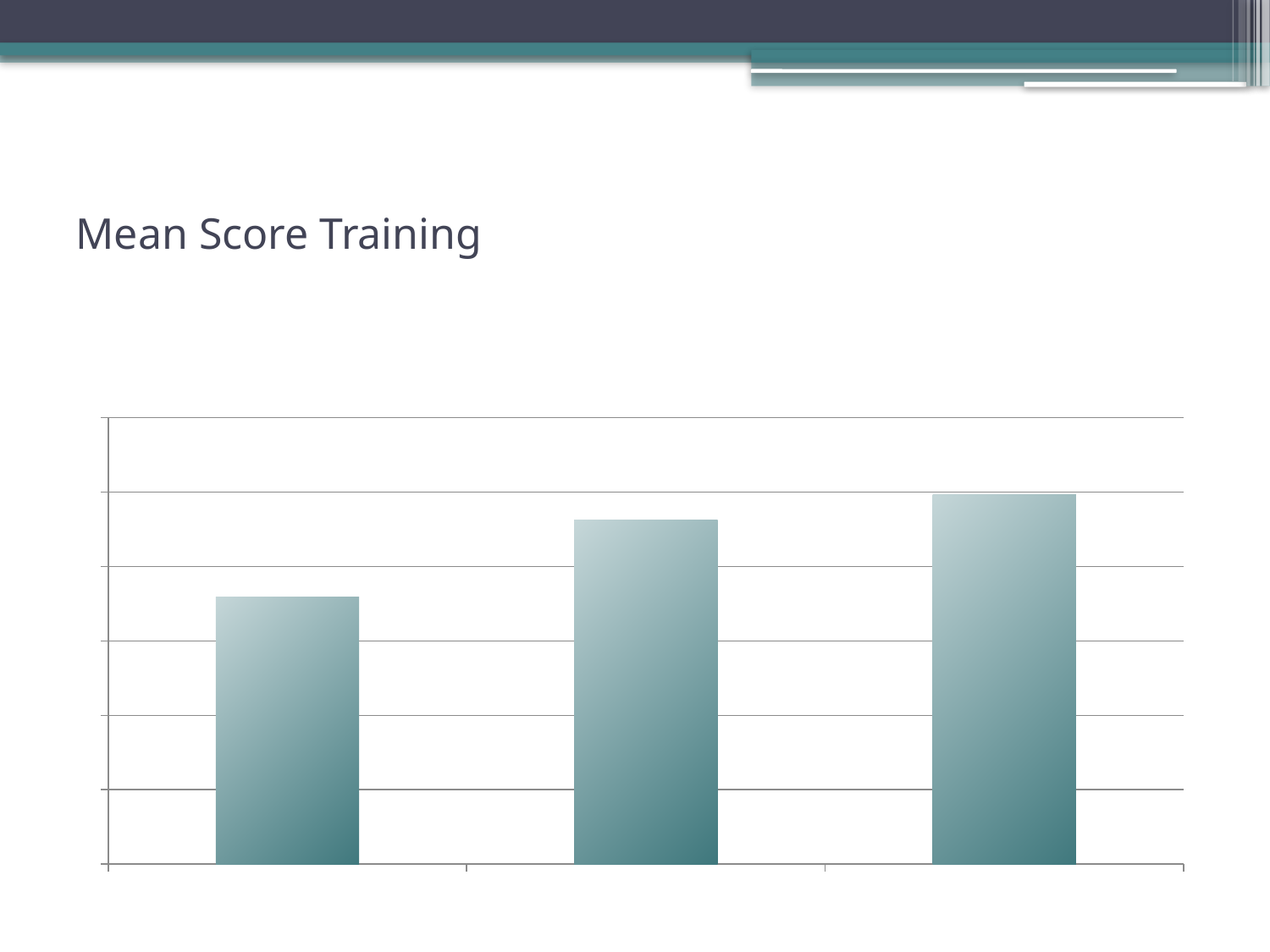
How many bars are plotted in the chart? 3 Which bar is the tallest: the left, middle, or right bar? right What kind of chart is shown on the slide? bar chart Which bar is the shortest: the left, middle, or right bar? left Is the middle bar taller or shorter than the left bar? taller Does the chart display a legend? No Is the right bar taller or shorter than the middle bar? taller Do the bar heights rise or fall from left to right across the chart? rise What is the title shown on the slide above the chart? Mean Score Training